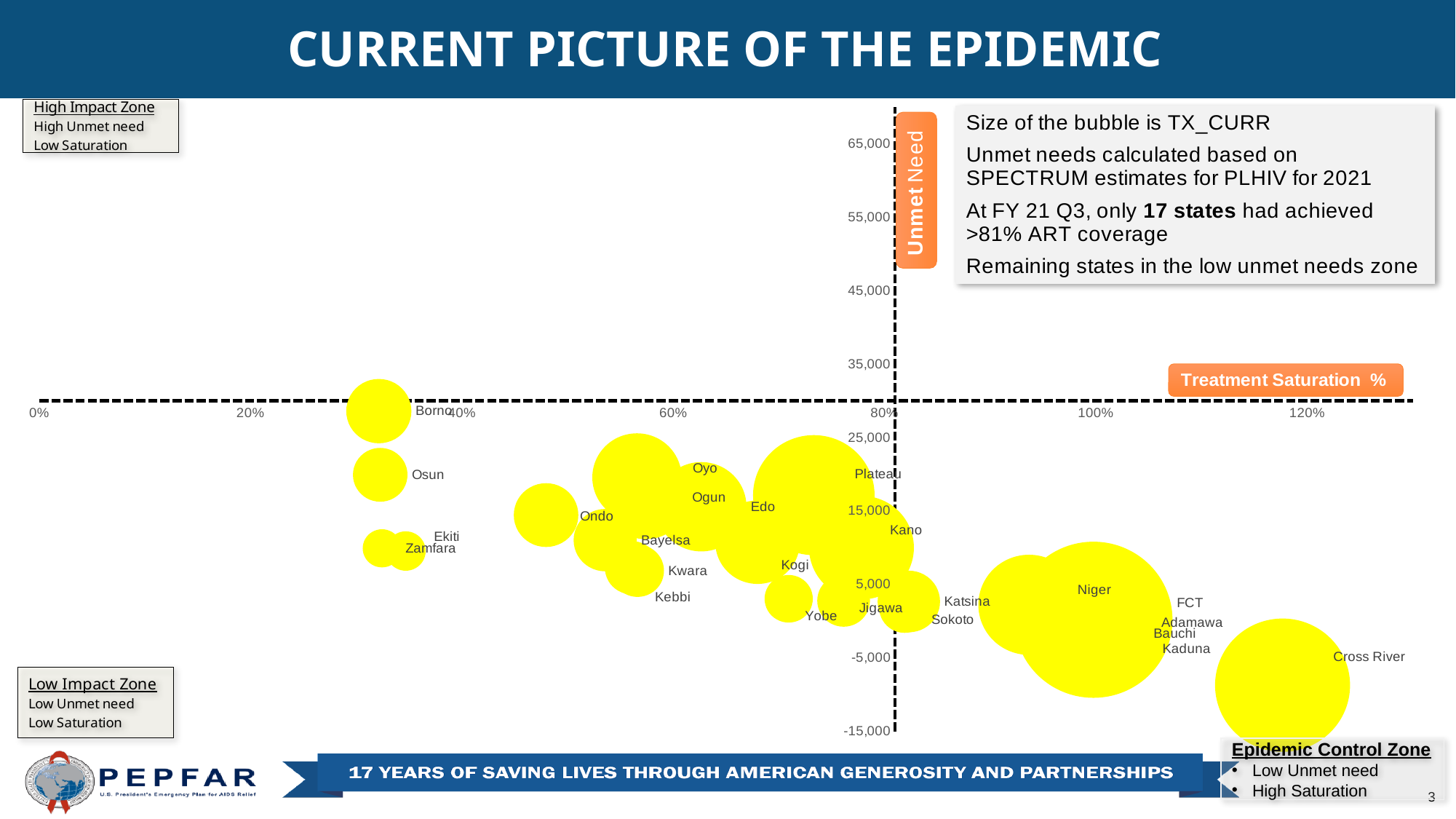
Is the unmet need for Cross River greater or less than 5,000? less Which state has the highest treatment saturation on the chart? Cross River As treatment saturation increases along the x axis, does unmet need generally rise or fall? fall Which state has the higher unmet need, Borno or Cross River? Borno Is the unmet need for Borno greater or less than 25,000? greater Which state has the lowest unmet need on the chart? Cross River Is the treatment saturation for Borno greater or less than 40%? less What kind of chart is shown on the slide? bubble chart What does the horizontal axis of the chart represent? Treatment Saturation % Which state has the highest unmet need on the chart? Borno What does the size of each bubble represent? TX_CURR